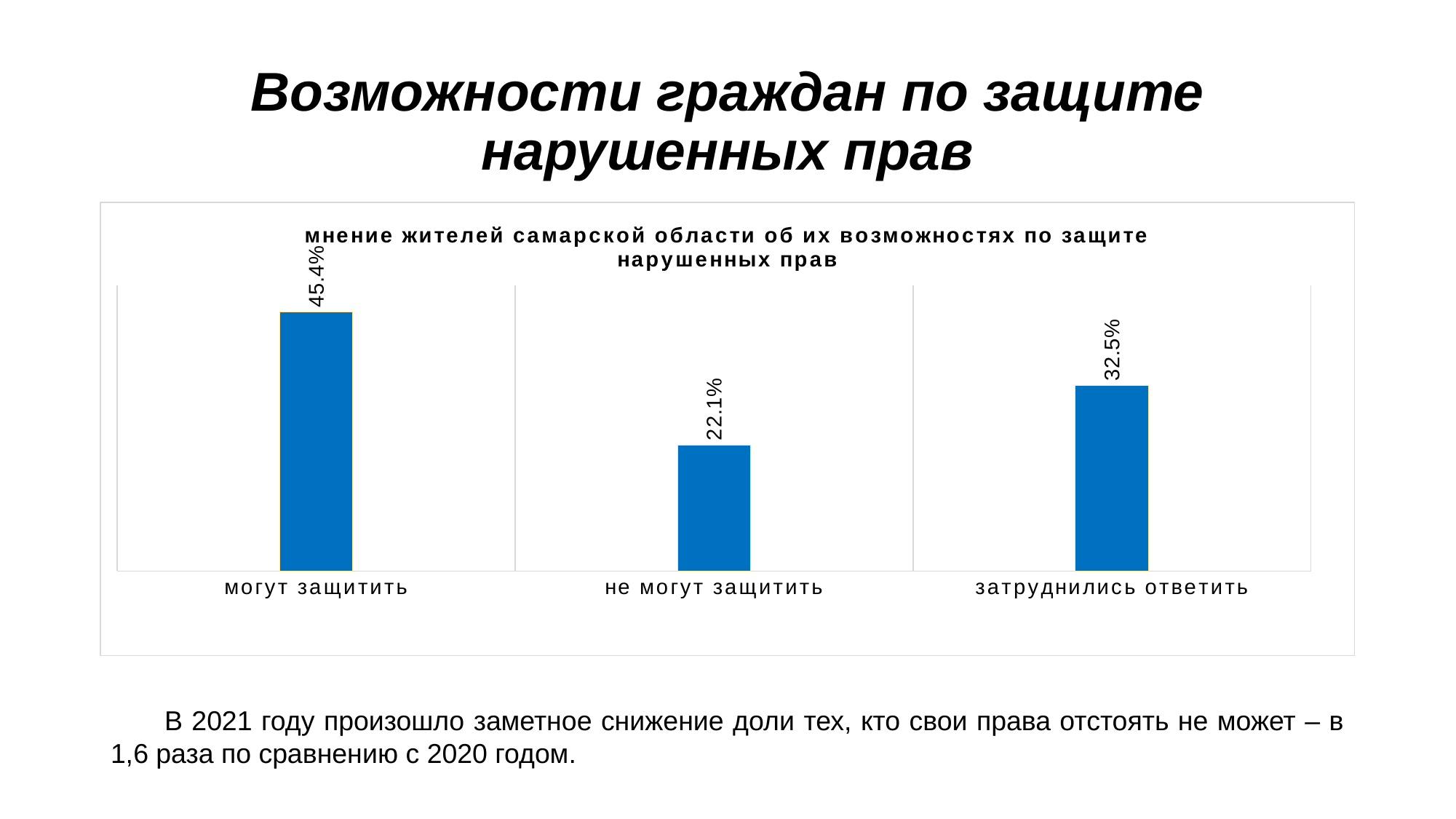
What is the difference between the values for 'могут защитить' and 'не могут защитить'? 23.3% What is the difference between the values for 'затруднились ответить' and 'не могут защитить'? 10.4% Which is larger: the value for 'затруднились ответить' or the value for 'не могут защитить'? затруднились ответить Which category has the highest value? могут защитить How many categories are shown in the chart? 3 What colour are the bars in the chart? blue What is the value for 'затруднились ответить'? 32.5% What is the title of the chart? мнение жителей самарской области об их возможностях по защите нарушенных прав What is the value for 'не могут защитить'? 22.1% Which category has the lowest value? не могут защитить What kind of chart is shown on the slide? bar chart What is the value for 'могут защитить'? 45.4%